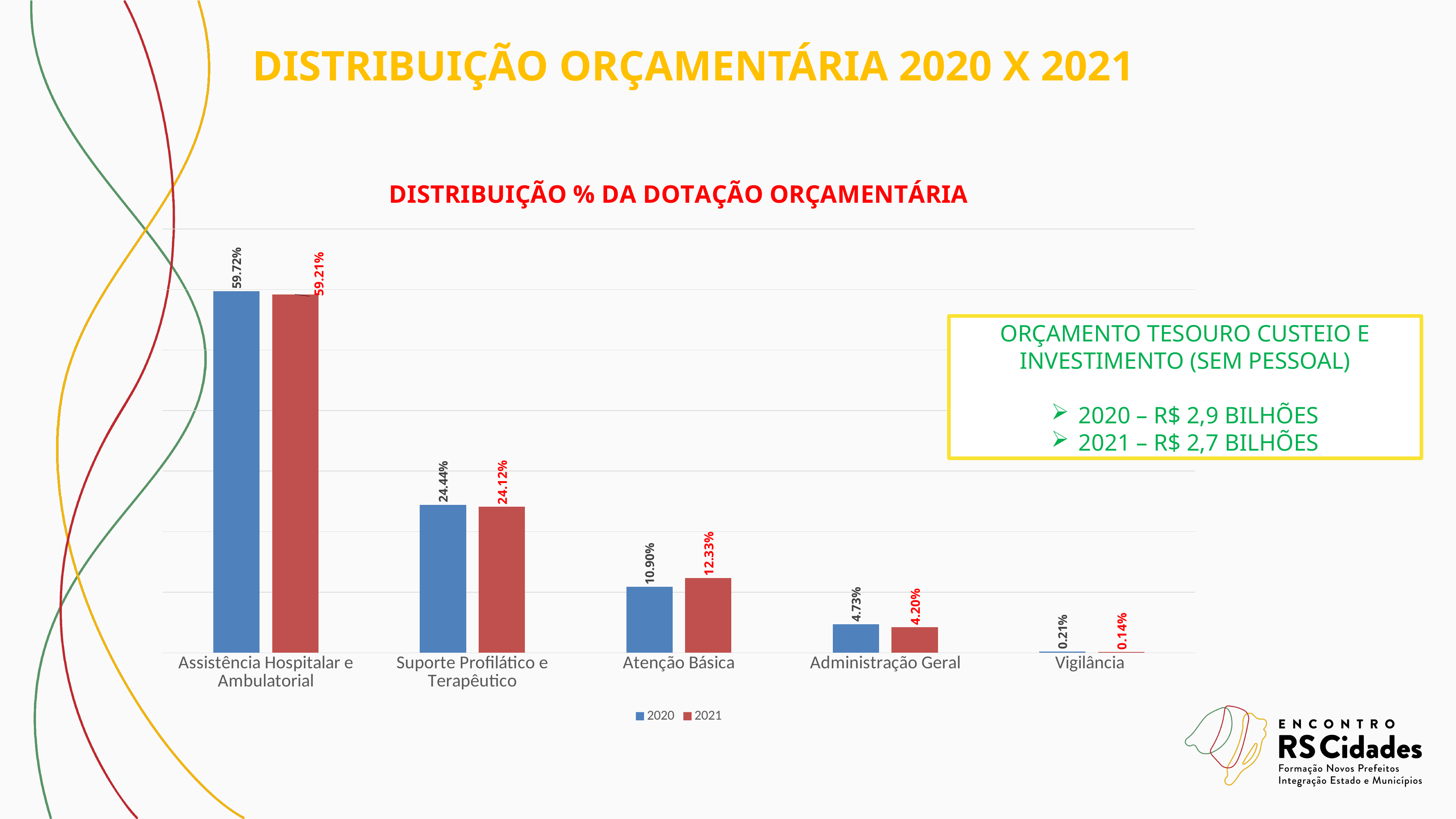
What is the 2020 value for Administração Geral? 4.73% Which category has the highest 2021 value? Assistência Hospitalar e Ambulatorial Which category has the lowest 2020 value? Vigilância What kind of chart is shown? Bar chart For Atenção Básica, which year has the larger value, 2020 or 2021? 2021 What is the 2021 value for Atenção Básica? 12.33% What is the title of the chart? DISTRIBUIÇÃO % DA DOTAÇÃO ORÇAMENTÁRIA What is the 2021 value for Vigilância? 0.14% What is the difference between the 2020 and 2021 values for Suporte Profilático e Terapêutico? 0.32% How many categories are shown on the x axis? 5 What is the 2020 value for Assistência Hospitalar e Ambulatorial? 59.72% How many series does the legend list? 2